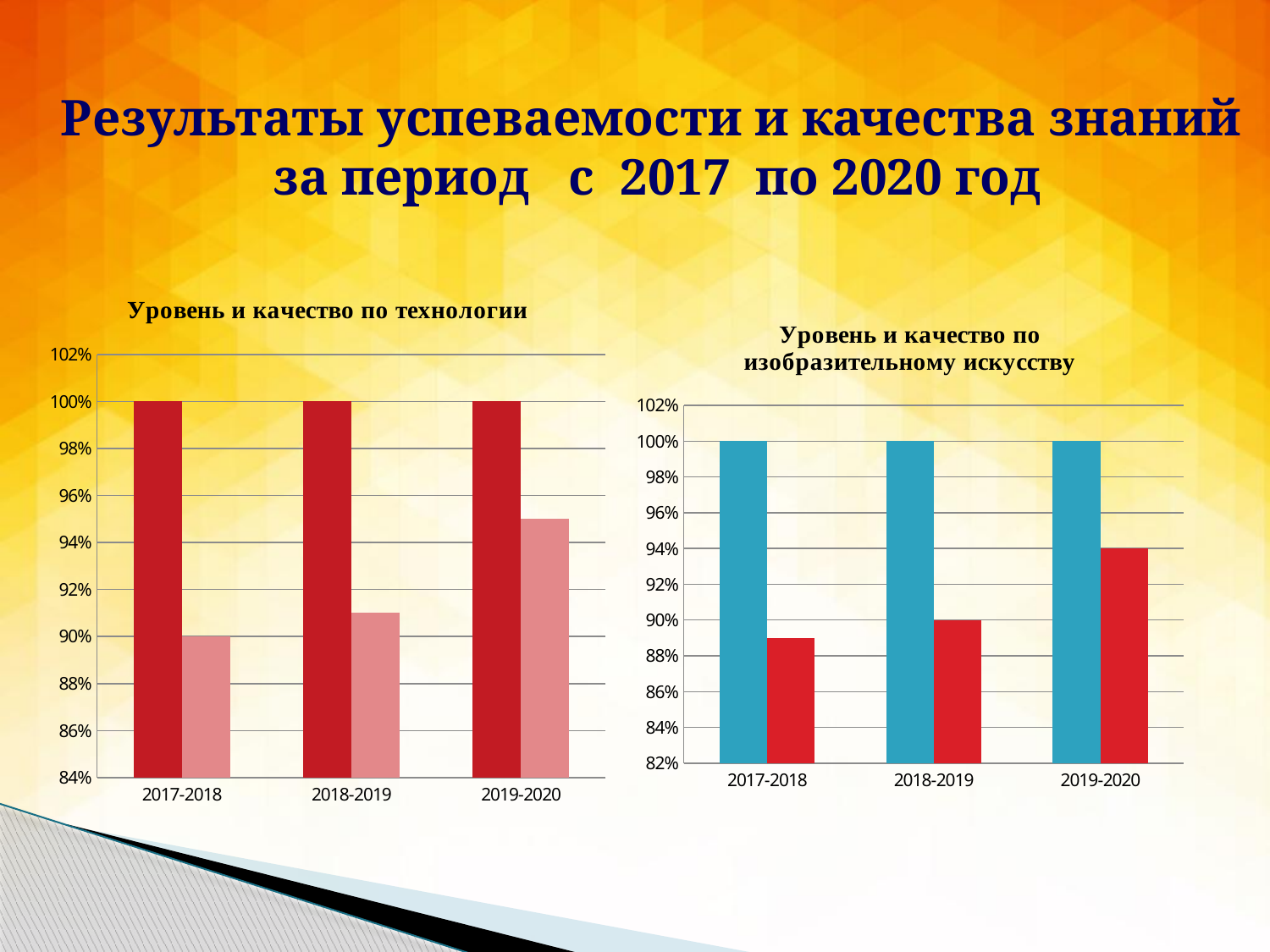
In the chart 'Уровень и качество по технологии', what is the value of the dark red bar for 2019-2020? 100% How many charts are on the slide? 2 In the chart 'Уровень и качество по изобразительному искусству', what is the value of the blue bar for 2017-2018? 100% In the chart 'Уровень и качество по технологии', how many categories are shown on the x axis? 3 In the chart 'Уровень и качество по технологии', do the pink bars rise or fall from 2017-2018 to 2019-2020? rise In the chart 'Уровень и качество по технологии', is the pink bar for 2019-2020 greater or less than 94%? greater In the chart 'Уровень и качество по технологии', which year has the highest pink bar? 2019-2020 In the chart 'Уровень и качество по изобразительному искусству', is the red bar for 2017-2018 greater or less than 90%? less In the chart 'Уровень и качество по изобразительному искусству', what is the value of the red bar for 2019-2020? 94% What kind of chart is 'Уровень и качество по технологии'? bar chart In the chart 'Уровень и качество по изобразительному искусству', which year has the lowest red bar? 2017-2018 In the chart 'Уровень и качество по технологии', what is the value of the pink bar for 2017-2018? 90%